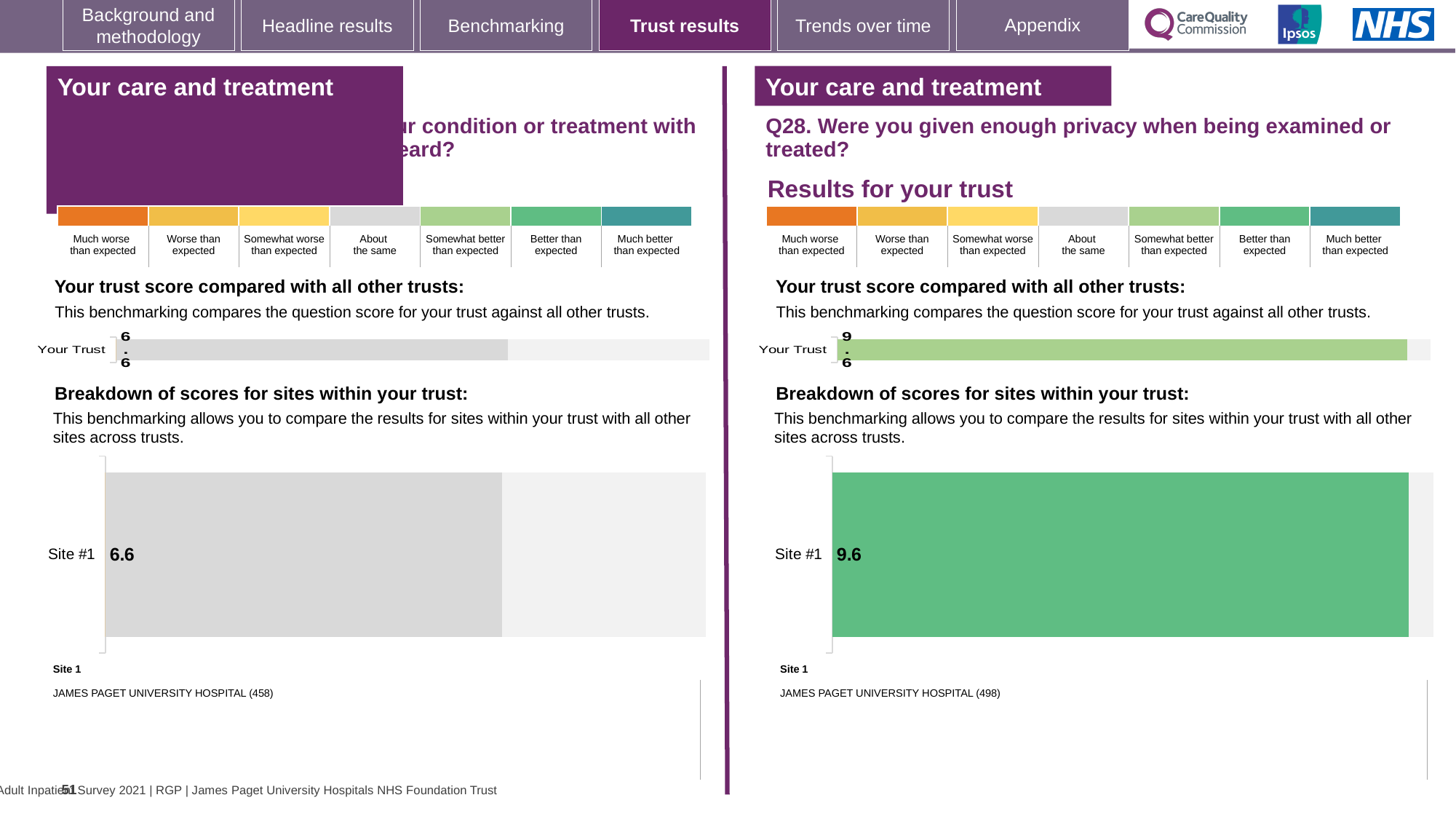
How many sites are shown in the breakdown of scores chart on the right-hand side (Q28)? 1 Which is larger: the Site #1 score on the left-hand chart or the Site #1 score on the right-hand (Q28) chart? Right-hand (Q28) chart On the left-hand side, what is the trust score shown in the 'Your Trust' bar chart? 6.6 On the right-hand side (Q28), which benchmark category does the green colour of the Site #1 bar correspond to in the legend? Better than expected What type of chart is used to show the Site #1 score on the right-hand side (Q28)? Bar chart How many sites are shown in the breakdown of scores chart on the left-hand side? 1 On the right-hand side (Q28), what is the trust score shown in the 'Your Trust' bar chart? 9.6 On the right-hand side (Q28), what score is shown for Site #1 in the breakdown of scores chart? 9.6 On the left-hand side, which benchmark category does the grey colour of the Site #1 bar correspond to in the legend? About the same On the left-hand side, what score is shown for Site #1 in the breakdown of scores chart? 6.6 What is the difference between the Site #1 score on the right-hand (Q28) chart and the Site #1 score on the left-hand chart? 3.0 On the right-hand side (Q28), what is the name of the site listed as Site 1 below the chart? JAMES PAGET UNIVERSITY HOSPITAL (498)